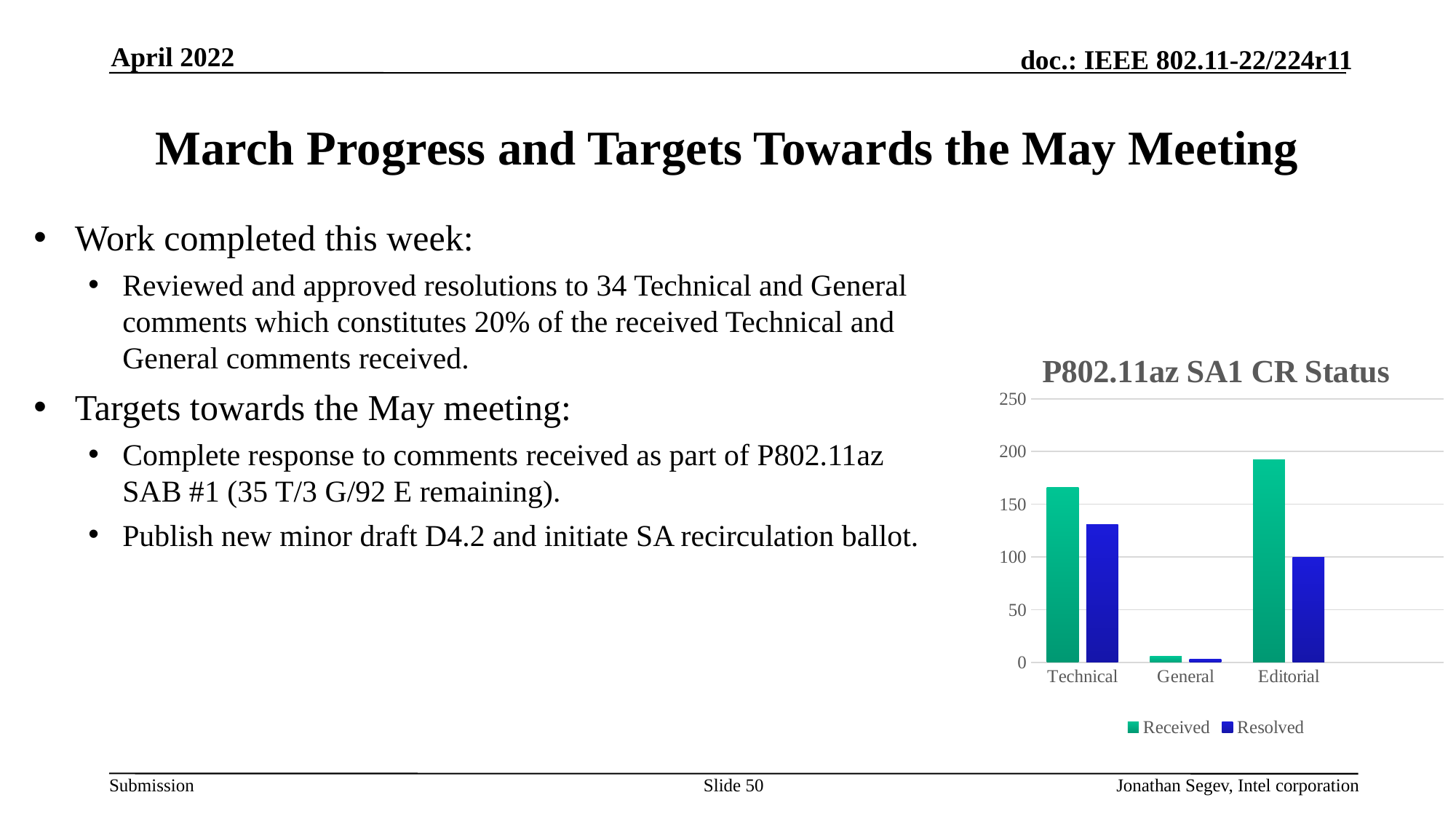
Is the Resolved value for Editorial greater or less than 150? less How many categories are shown on the x axis of the chart? 3 Which category has the lowest Received value? General Is the Received value for Technical greater or less than 150? greater Is the Received value for General greater or less than 50? less Which is larger: the Resolved value for Technical or the Resolved value for Editorial? Technical Which series is shown in dark blue in the chart legend? Resolved How many series does the chart legend list? 2 Which category has the highest Received value? Editorial What is the title of the chart? P802.11az SA1 CR Status Which category has the highest Resolved value? Technical What type of chart is shown on the slide? bar chart